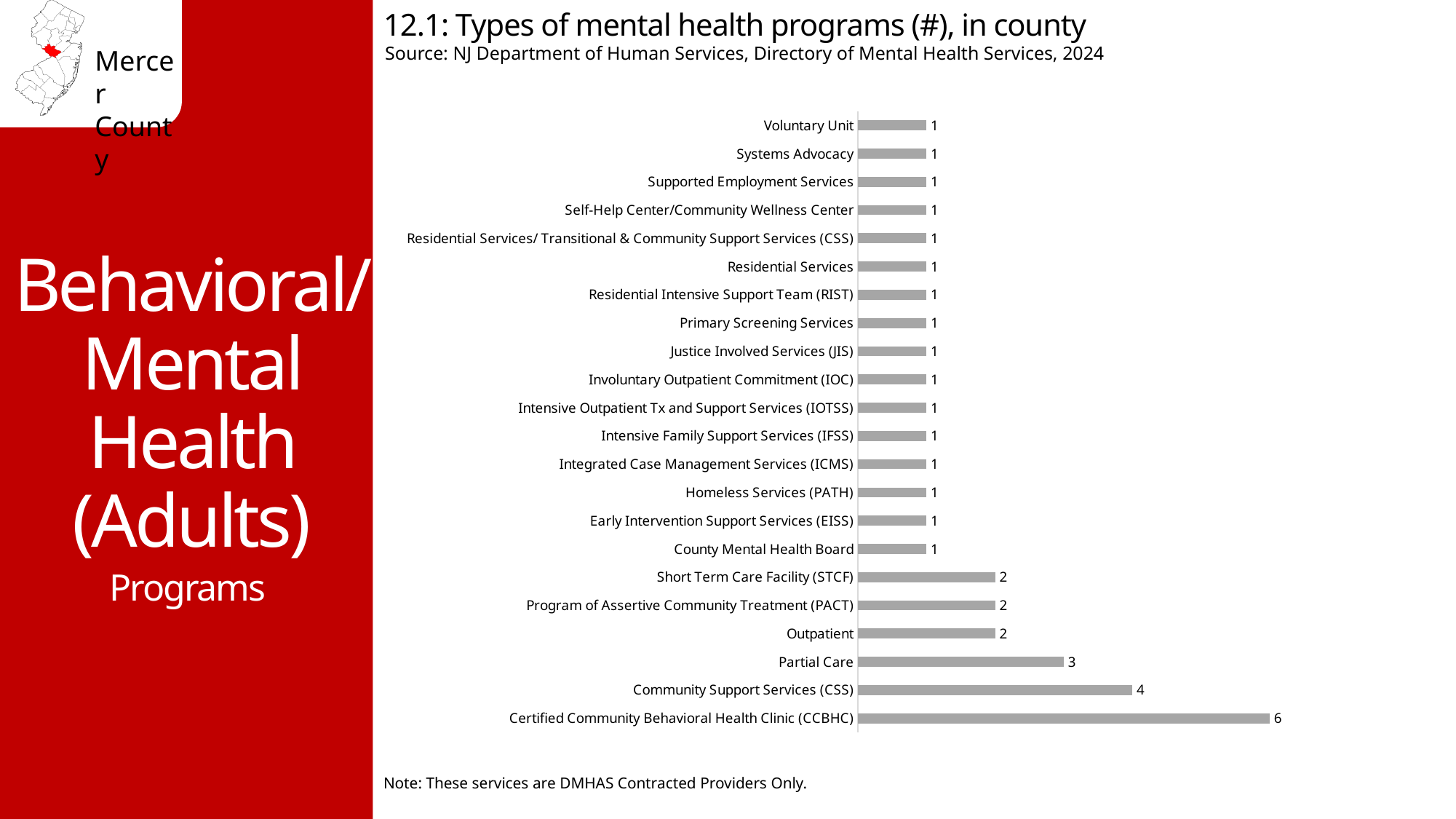
Which is larger, the value for Partial Care or the value for Short Term Care Facility (STCF)? Partial Care How many categories are shown in the chart? 22 What kind of chart is shown on the slide? bar chart Which category has the highest number of programs? Certified Community Behavioral Health Clinic (CCBHC) What is the value for Community Support Services (CSS)? 4 What is the value for Outpatient? 2 What is the difference between the values for Certified Community Behavioral Health Clinic (CCBHC) and Community Support Services (CSS)? 2 How many programs does the Certified Community Behavioral Health Clinic (CCBHC) category have? 6 What is the value for Partial Care? 3 What is the title of the chart? 12.1: Types of mental health programs (#), in county What is the difference between the values for Community Support Services (CSS) and Program of Assertive Community Treatment (PACT)? 2 What is the value for Homeless Services (PATH)? 1